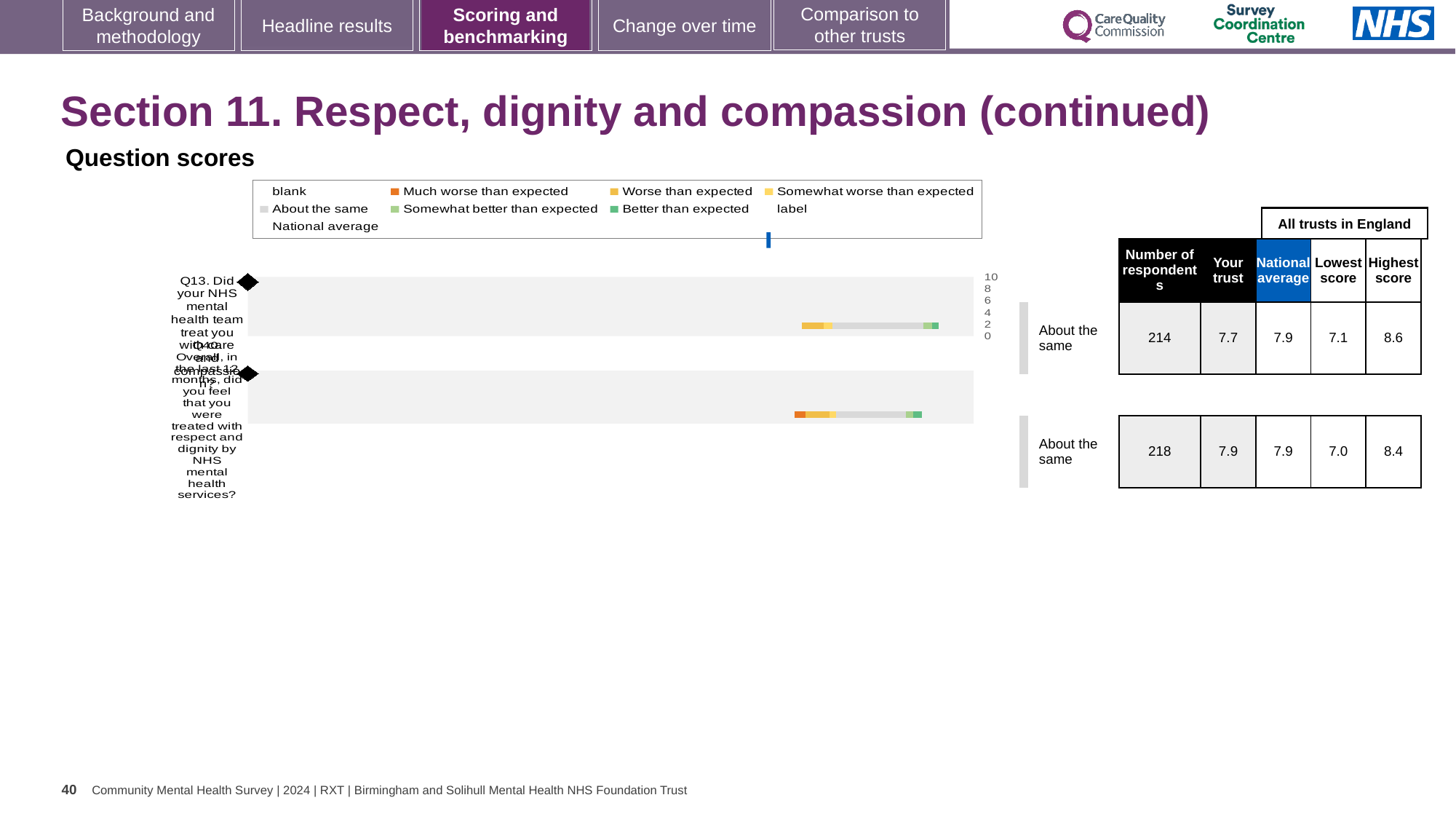
What benchmark category is shown for Q13 in the chart? About the same What is the national average score for Q13? 7.9 What kind of chart is used to show the question scores on this slide? bar chart What is the difference between the highest and lowest scores for Q13? 1.5 How many survey questions are plotted in the question scores chart? 2 Which question has the higher 'Your trust' score, Q13 or Q14? Q14 What is the 'Your trust' score for Q13 (Did your NHS mental health team treat you with care and compassion?)? 7.7 What is the highest score among all trusts in England for Q13? 8.6 How many respondents are listed for Q14 (treated with respect and dignity by NHS mental health services)? 218 Which question has the higher 'Highest score' value, Q13 or Q14? Q13 What is the lowest score among all trusts in England for Q14? 7.0 How many more respondents answered Q14 than Q13? 4